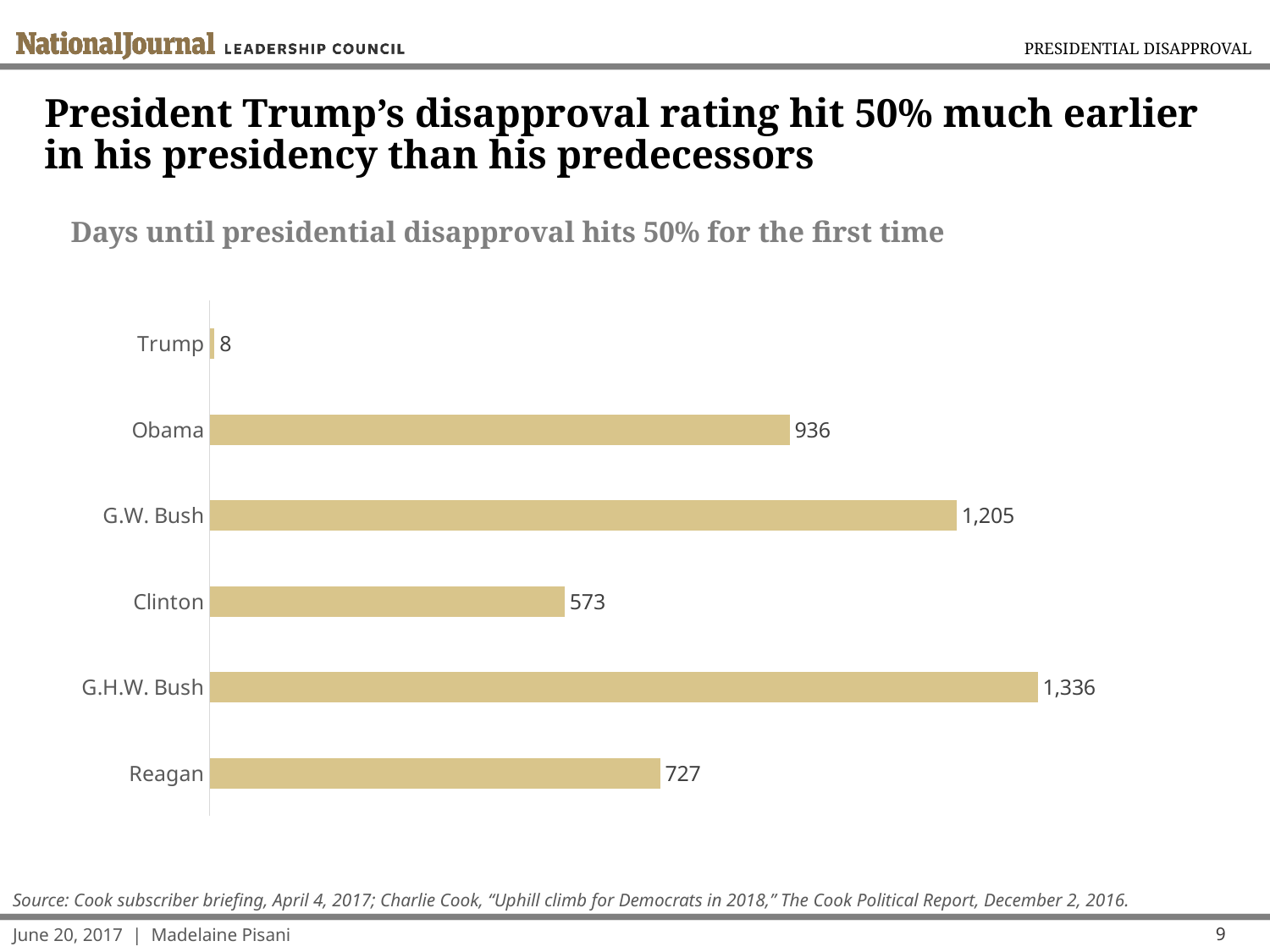
What is the subtitle of the chart? Days until presidential disapproval hits 50% for the first time What is the difference in days between G.W. Bush and Obama? 269 What type of chart is shown on the slide? Bar chart Who took more days to reach 50% disapproval, G.H.W. Bush or G.W. Bush? G.H.W. Bush How many days until disapproval hit 50% are shown for Clinton? 573 What is the value shown for Trump? 8 Which president has the lowest number of days until disapproval hit 50%? Trump How many presidents are shown in the chart? 6 Which president has the highest number of days until disapproval hit 50%? G.H.W. Bush Who took more days to reach 50% disapproval, Reagan or Obama? Obama What is the difference in days between Reagan and Clinton? 154 How many days did it take for Obama's disapproval rating to hit 50% for the first time? 936